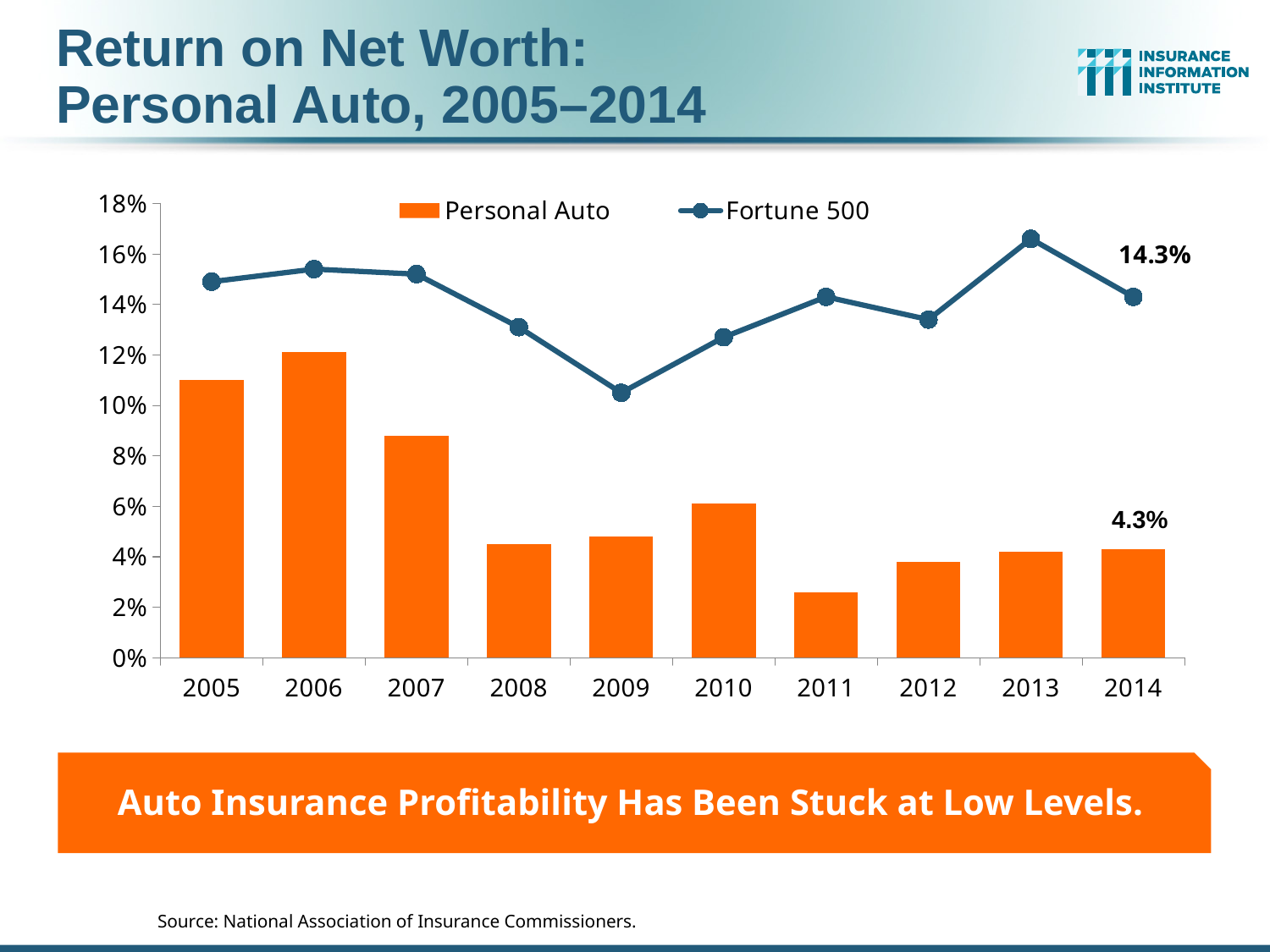
What is the Fortune 500 return on net worth for 2014? 14.3% Is the Fortune 500 value for 2009 greater or less than 12%? less Which year has the lowest Personal Auto return on net worth? 2011 Is the Personal Auto value for 2005 greater or less than 10%? greater In 2014, how much higher is the Fortune 500 value than the Personal Auto value? 10 percentage points Which year has the highest Personal Auto return on net worth? 2006 What is the Personal Auto return on net worth for 2014? 4.3% How many series does the legend list? 2 Which year has the highest Fortune 500 return on net worth? 2013 Which year has the lowest Fortune 500 return on net worth? 2009 What kind of chart is shown on the slide? A bar chart combined with a line chart How many years are shown on the x axis? 10